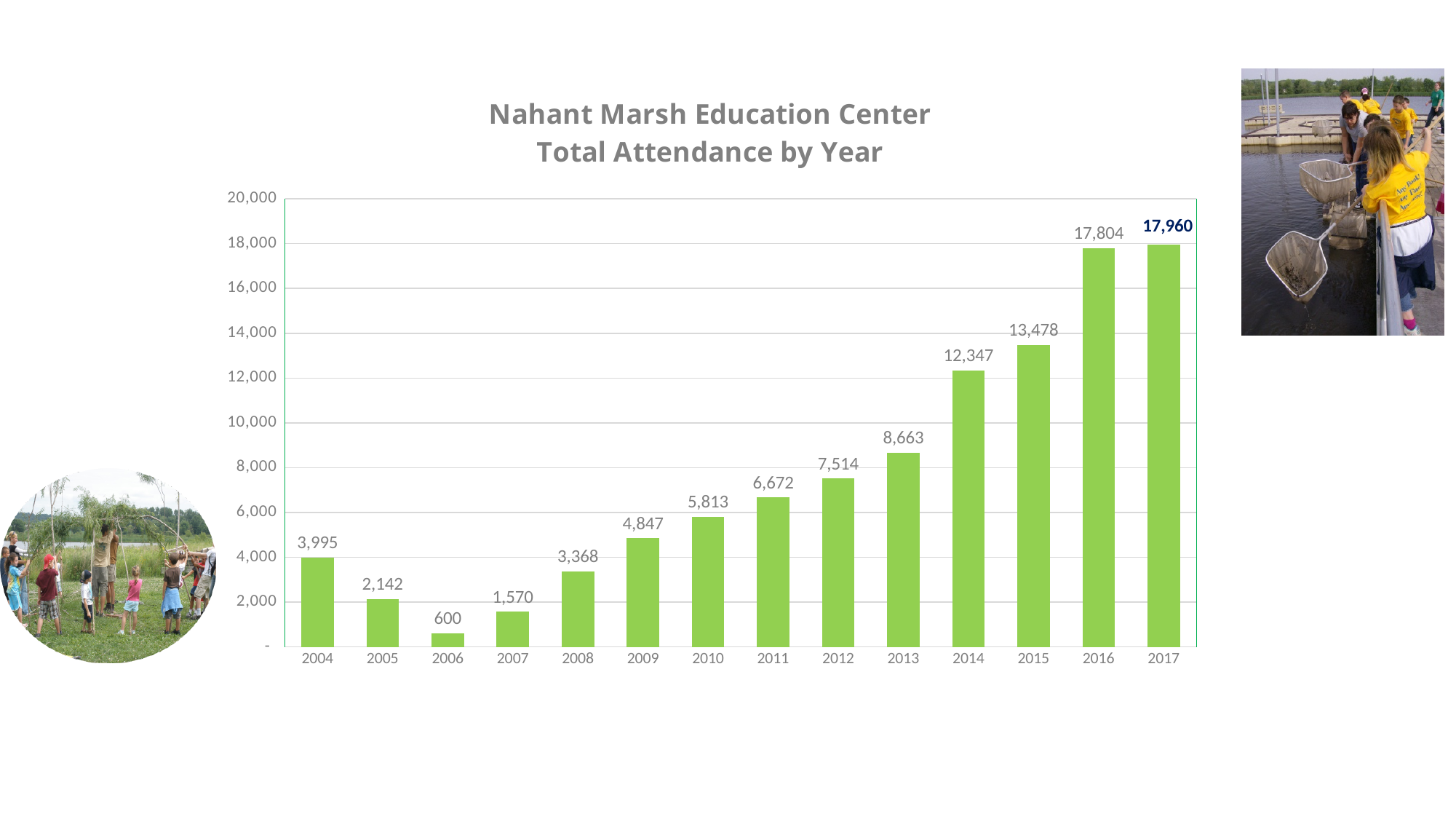
Is the attendance for 2012 greater or less than 8,000? less What is the difference in attendance between 2017 and 2016? 156 What is the difference in attendance between 2014 and 2013? 3,684 Which year had the highest total attendance? 2017 How many years are shown on the chart? 14 What was the total attendance in 2006? 600 Which year had the lowest total attendance? 2006 What is the title of the chart? Nahant Marsh Education Center Total Attendance by Year Which year had higher attendance, 2004 or 2008? 2004 What was the total attendance in 2010? 5,813 What kind of chart is shown on the slide? Bar chart What was the total attendance in 2015? 13,478